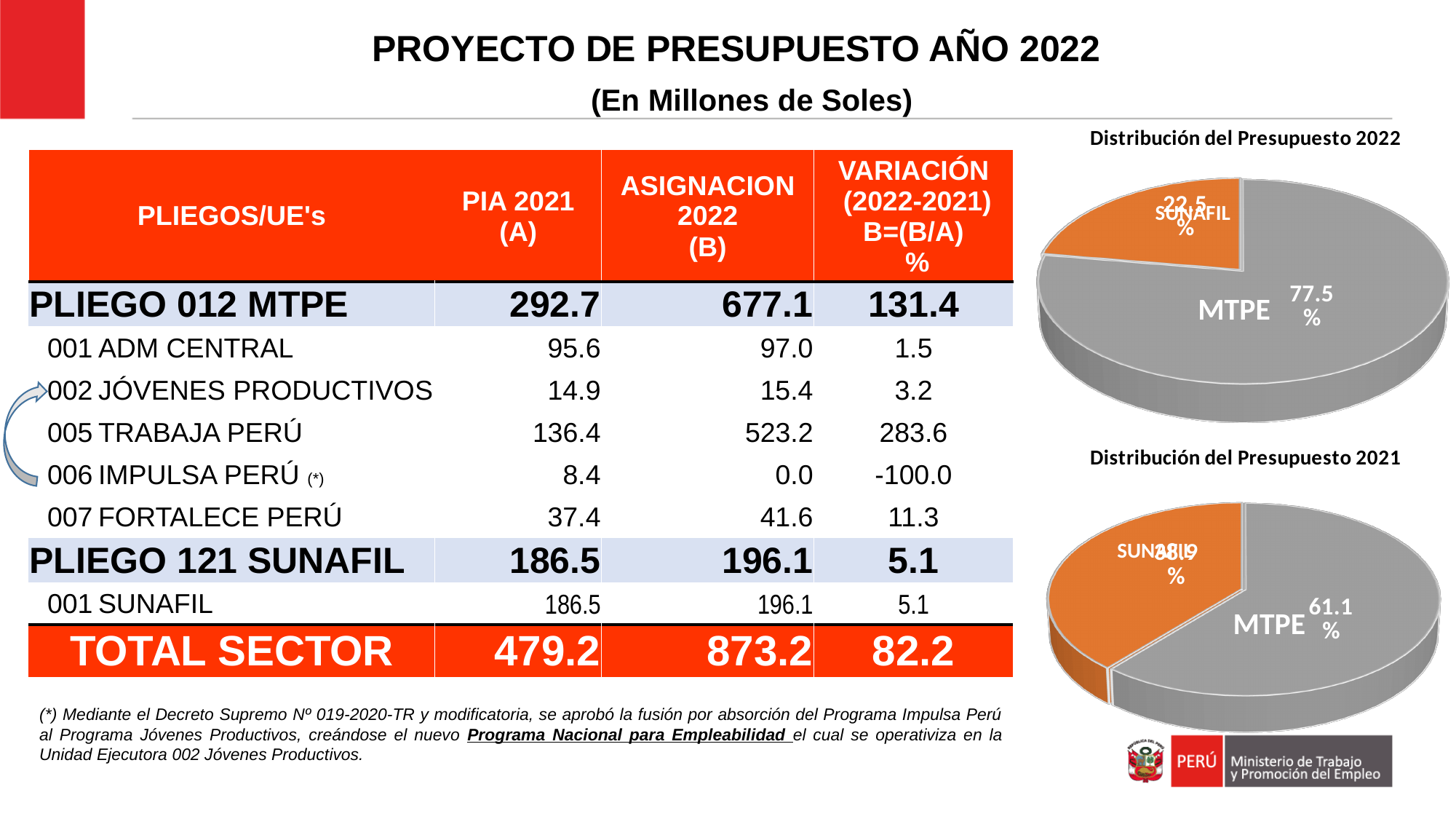
In the 'Distribución del Presupuesto 2021' chart, what share does MTPE have? 61.1% In the 'Distribución del Presupuesto 2021' chart, which is larger, the MTPE slice or the SUNAFIL slice? MTPE How many slices does the 'Distribución del Presupuesto 2022' pie chart have? 2 In the 'Distribución del Presupuesto 2021' chart, what share does SUNAFIL have? 38.9% In the 'Distribución del Presupuesto 2022' chart, which slice is the largest? MTPE In the 'Distribución del Presupuesto 2022' chart, what is the difference in percentage points between the MTPE and SUNAFIL shares? 55.0 percentage points In the 'Distribución del Presupuesto 2022' chart, what share does SUNAFIL have? 22.5% Is the MTPE share larger in the 'Distribución del Presupuesto 2022' chart or in the 'Distribución del Presupuesto 2021' chart? Distribución del Presupuesto 2022 What kind of chart is the 'Distribución del Presupuesto 2022' chart? Pie chart What colour is the SUNAFIL slice in the 'Distribución del Presupuesto 2022' chart? Orange In the 'Distribución del Presupuesto 2021' chart, which slice is the smallest? SUNAFIL In the 'Distribución del Presupuesto 2022' chart, what share does MTPE have? 77.5%